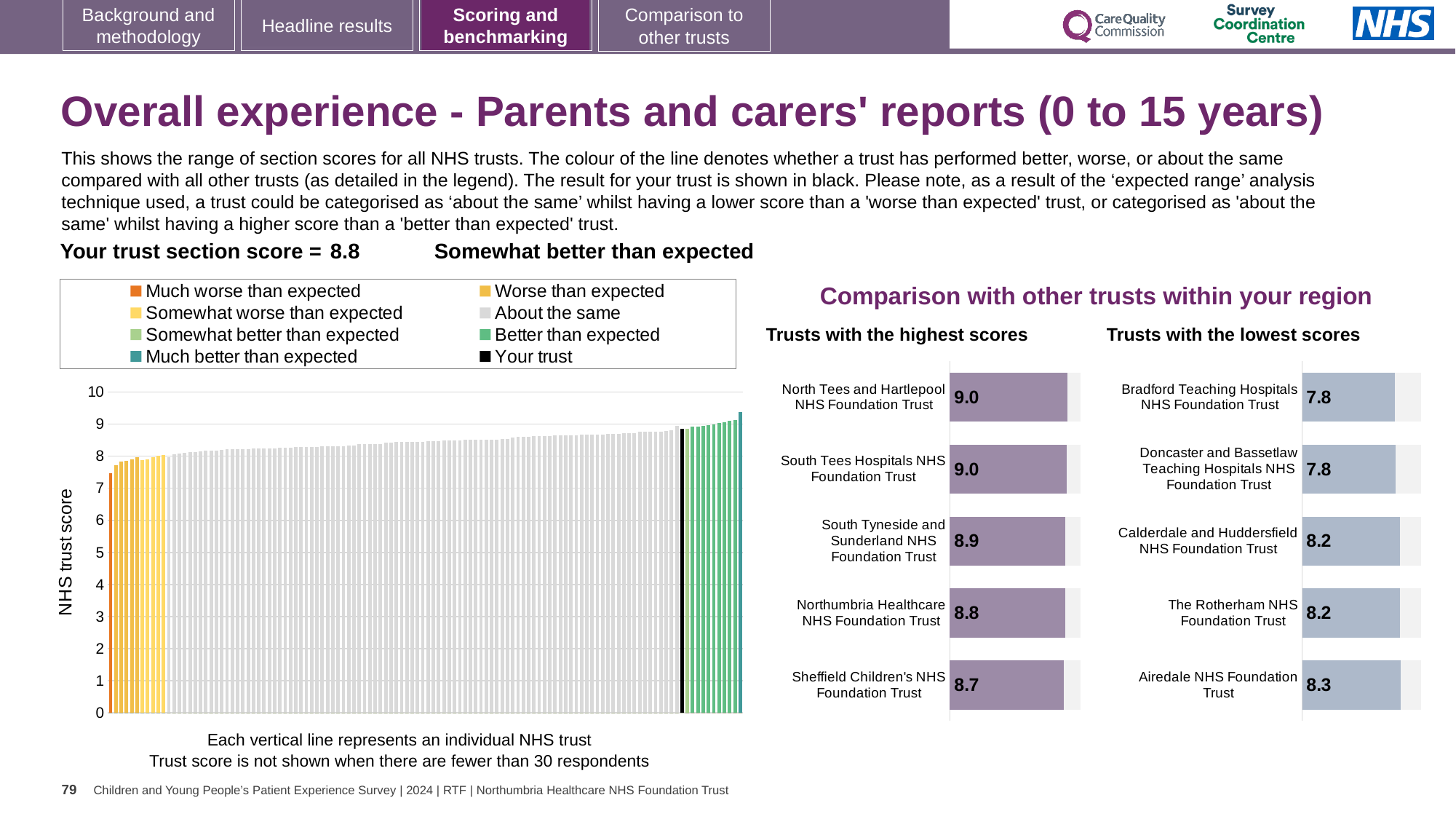
In the 'Trusts with the highest scores' chart, what is the difference between the scores of North Tees and Hartlepool NHS Foundation Trust and Sheffield Children's NHS Foundation Trust? 0.3 In the 'Trusts with the lowest scores' chart, which trust has the highest score? Airedale NHS Foundation Trust In the 'Trusts with the lowest scores' chart, which has the larger score: Calderdale and Huddersfield NHS Foundation Trust or Airedale NHS Foundation Trust? Airedale NHS Foundation Trust In the 'Trusts with the lowest scores' chart, what is the score for Calderdale and Huddersfield NHS Foundation Trust? 8.2 In the large chart on the left, is the value for the black 'Your trust' bar greater or less than 8? greater How many entries does the legend of the large chart on the left list? 8 What kind of chart is the large chart on the left showing NHS trust scores? Bar chart In the 'Trusts with the lowest scores' chart, what is the difference between the scores of Airedale NHS Foundation Trust and Bradford Teaching Hospitals NHS Foundation Trust? 0.5 In the 'Trusts with the highest scores' chart, what is the score for Northumbria Healthcare NHS Foundation Trust? 8.8 In the 'Trusts with the highest scores' chart, what is the score for South Tyneside and Sunderland NHS Foundation Trust? 8.9 How many trusts are shown in the 'Trusts with the highest scores' chart? 5 In the 'Trusts with the highest scores' chart, which trust has the lowest score? Sheffield Children's NHS Foundation Trust